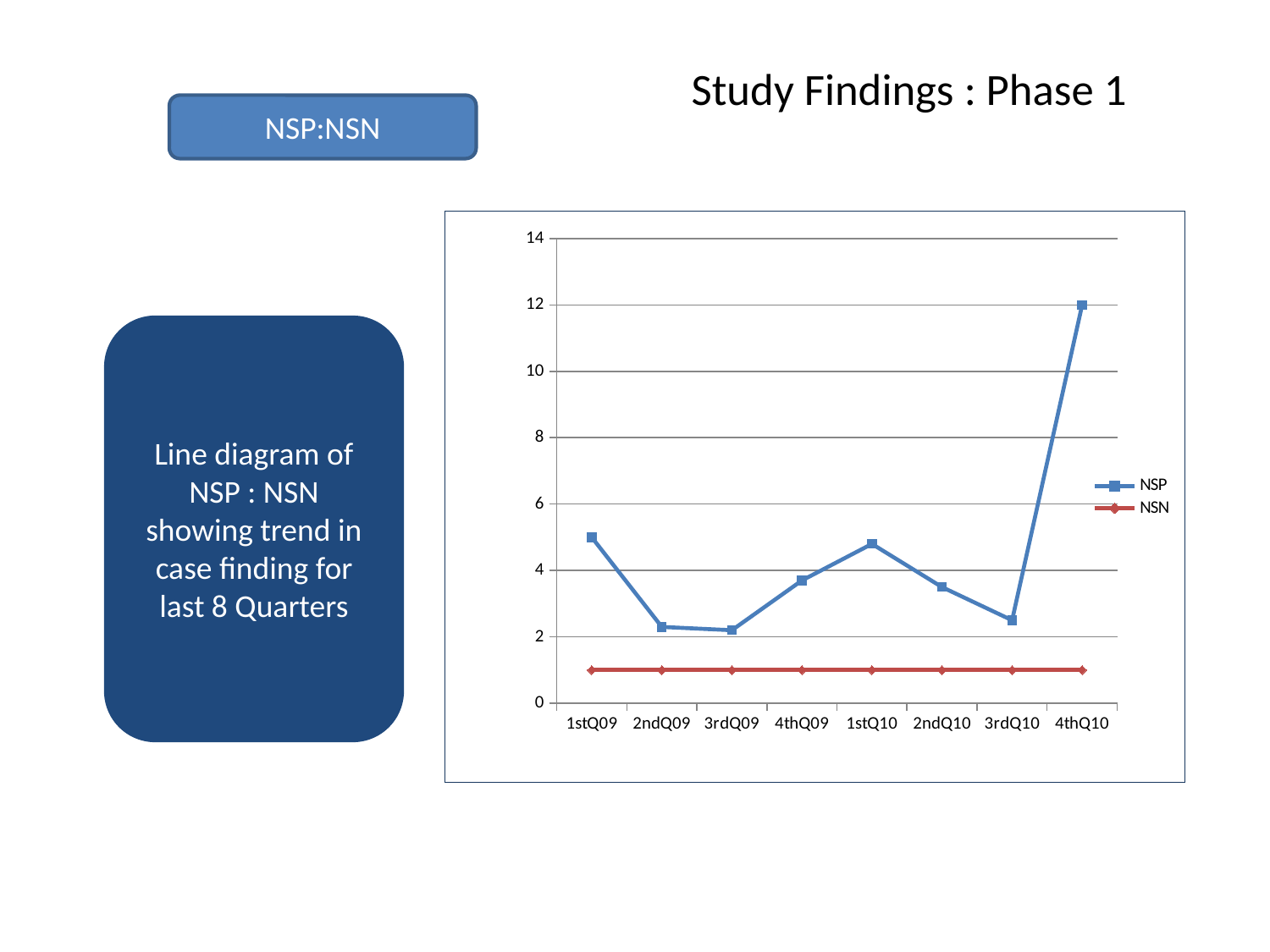
Which is larger, the NSP value for 1stQ09 or for 2ndQ09? 1stQ09 Does the NSN line rise, fall, or stay flat across the quarters? stays flat In which quarter is the NSP value highest? 4thQ10 Which series is drawn with the blue line? NSP Is the NSN value for 3rdQ10 greater or less than 2? less Is the NSP value for 2ndQ09 greater or less than 4? less What kind of chart is shown on the slide? line chart Is the NSP value for 1stQ09 greater or less than 4? greater How many series does the legend list? 2 How many quarters are plotted along the x axis? 8 Which is larger, the NSP value for 1stQ10 or for 2ndQ10? 1stQ10 What is the NSP value for 4thQ10? 12